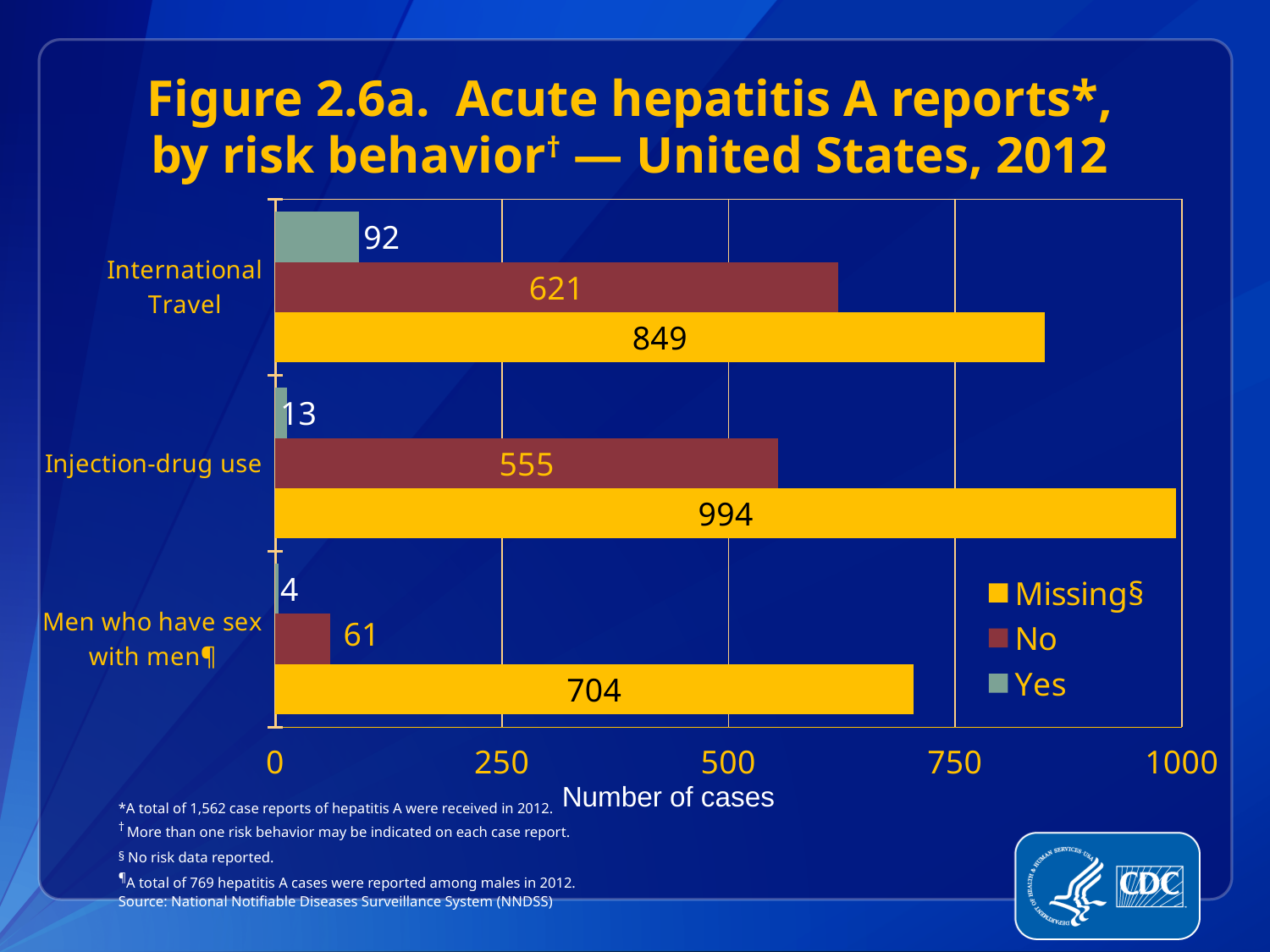
Which is larger: the 'Yes' value for International Travel or the 'Yes' value for Injection-drug use? International Travel What is the label of the x axis? Number of cases What is the number of cases for 'No' in the Men who have sex with men category? 61 How many series does the legend list? 3 Which risk behavior category has the highest 'Missing' value? Injection-drug use How many risk behavior categories are shown on the chart? 3 What is the number of cases for 'Missing' in the Injection-drug use category? 994 Which risk behavior category has the lowest 'Yes' value? Men who have sex with men What is the number of cases for 'Yes' in the International Travel category? 92 Is the 'Missing' value for Men who have sex with men greater or less than 750? less What is the difference between the 'No' values for International Travel and Injection-drug use? 66 What kind of chart is shown on the slide? bar chart